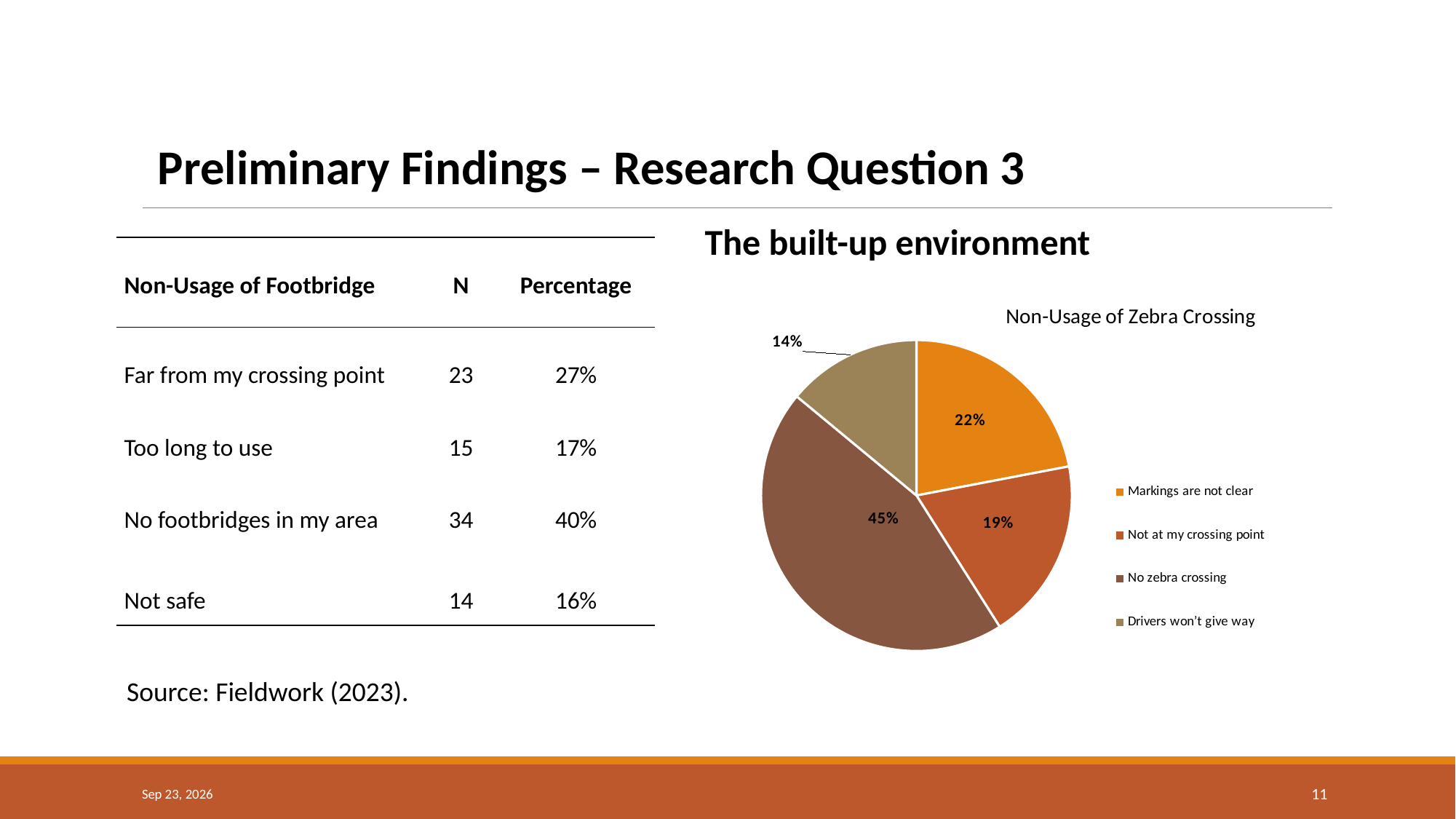
Which category has the smallest slice in the pie chart? Drivers won't give way What percentage of the pie chart is 'Not at my crossing point'? 19% How many slices does the pie chart have? 4 What percentage of the pie chart is 'No zebra crossing'? 45% What is the difference in percentage points between 'No zebra crossing' and 'Markings are not clear'? 23 What type of chart is shown on the slide? pie chart Which category has the largest slice in the pie chart? No zebra crossing What percentage of the pie chart is 'Drivers won't give way'? 14% How many entries does the pie chart's legend list? 4 What is the title of the pie chart? Non-Usage of Zebra Crossing Which is larger in the pie chart: 'Markings are not clear' or 'Not at my crossing point'? Markings are not clear What percentage of the pie chart is 'Markings are not clear'? 22%